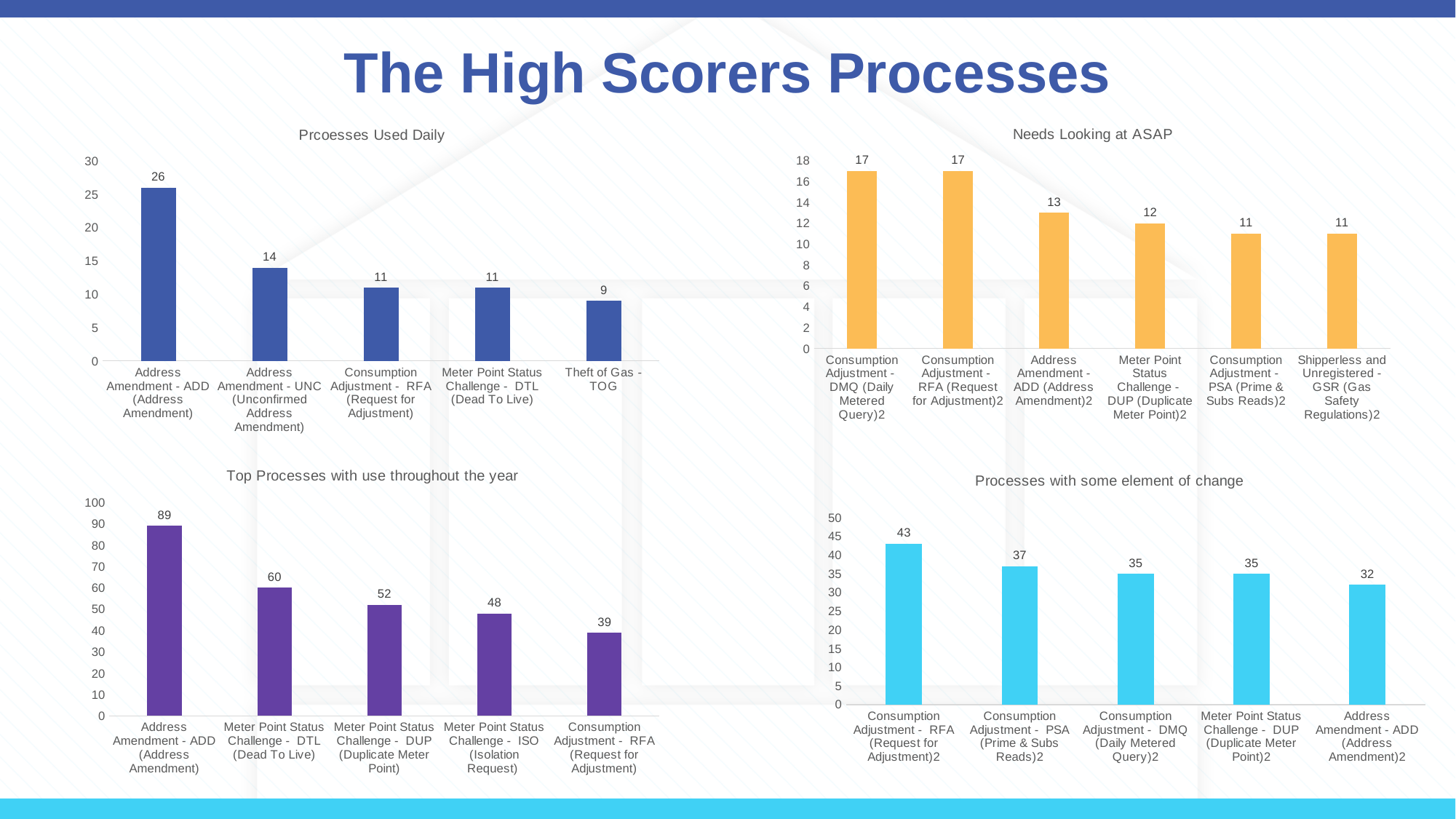
In the 'Top Processes with use throughout the year' chart, what is the value for Meter Point Status Challenge - ISO (Isolation Request)? 48 In the 'Top Processes with use throughout the year' chart, what is the difference between Meter Point Status Challenge - DTL (Dead To Live) and Consumption Adjustment - RFA (Request for Adjustment)? 21 In the 'Top Processes with use throughout the year' chart, which category has the highest value? Address Amendment - ADD (Address Amendment) In the 'Needs Looking at ASAP' chart, what is the value for Address Amendment - ADD (Address Amendment)2? 13 In the 'Processes with some element of change' chart, which is larger: Consumption Adjustment - RFA (Request for Adjustment)2 or Consumption Adjustment - PSA (Prime & Subs Reads)2? Consumption Adjustment - RFA (Request for Adjustment)2 In the 'Prcoesses Used Daily' chart, what is the value for Address Amendment - ADD (Address Amendment)? 26 What type of chart is the 'Processes with some element of change' chart? bar chart In the 'Processes with some element of change' chart, do the values rise or fall from left to right? fall In the 'Prcoesses Used Daily' chart, which category has the lowest value? Theft of Gas - TOG In the 'Needs Looking at ASAP' chart, what is the difference between Consumption Adjustment - DMQ (Daily Metered Query)2 and Meter Point Status Challenge - DUP (Duplicate Meter Point)2? 5 In the 'Needs Looking at ASAP' chart, how many categories are plotted? 6 In the 'Prcoesses Used Daily' chart, how many categories are plotted? 5